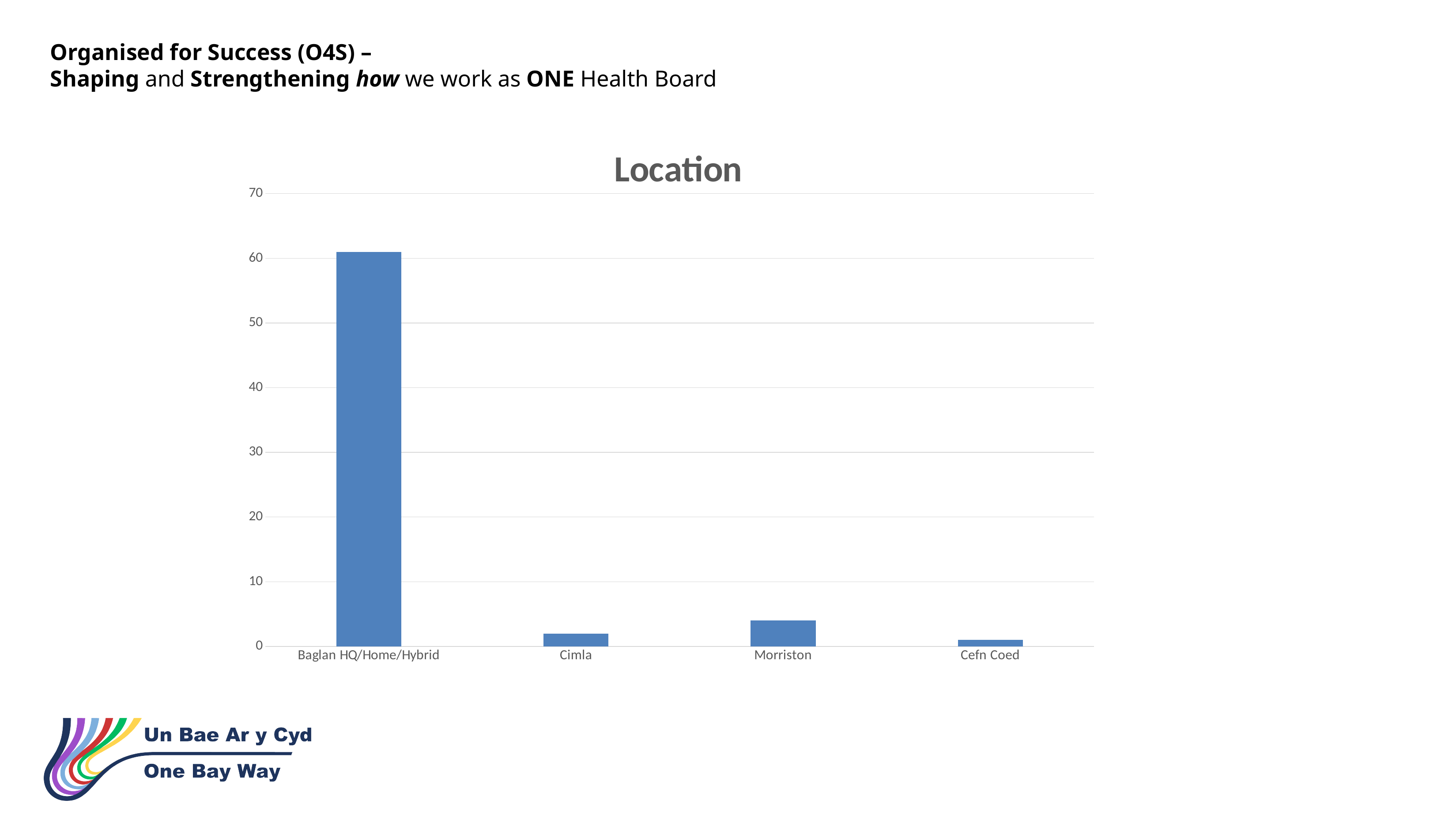
Is the value for Baglan HQ/Home/Hybrid greater or less than 70? less What is the title of the chart? Location Which has the larger value, Morriston or Cimla? Morriston Which location has the highest value in the chart? Baglan HQ/Home/Hybrid Which has the larger value, Cefn Coed or Baglan HQ/Home/Hybrid? Baglan HQ/Home/Hybrid Which location has the lowest value in the chart? Cefn Coed Is the value for Cimla greater or less than 10? less How many locations are shown on the x axis of the chart? 4 What type of chart is shown on the slide? bar chart What is the highest value shown on the vertical axis of the chart? 70 Is the value for Morriston greater or less than 10? less